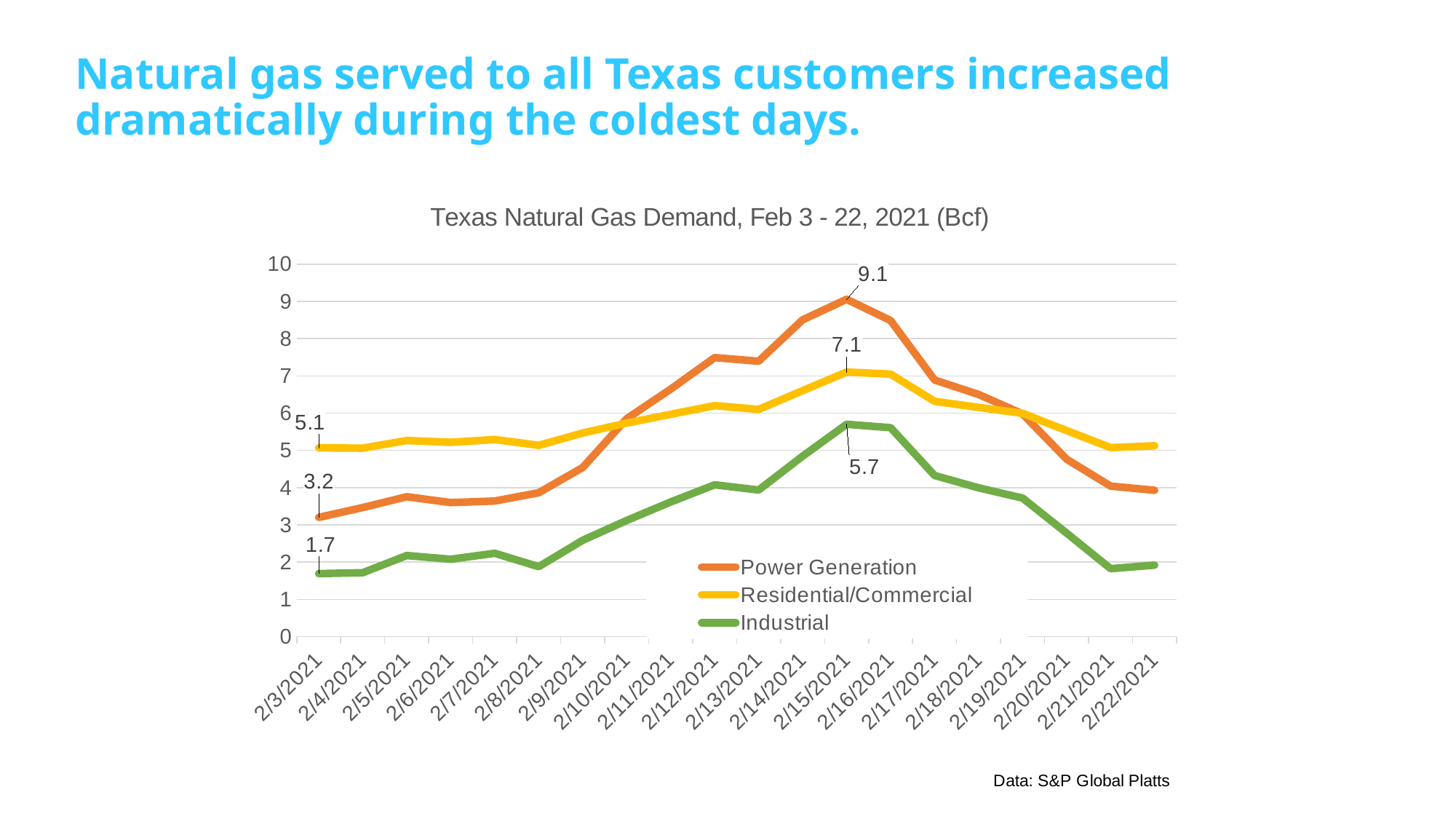
What is the Industrial value on 2/15/2021? 5.7 By how much did Power Generation demand increase from 2/3/2021 to 2/15/2021? 5.9 How many series does the legend list? 3 Does the Power Generation line rise or fall from 2/15/2021 to 2/22/2021? fall What is the Industrial value on 2/3/2021? 1.7 How many dates are plotted along the x axis? 20 Which series has the highest value on 2/15/2021? Power Generation What kind of chart is shown on the slide? line chart Is the Power Generation value on 2/12/2021 greater or less than 7? greater What is the Power Generation value on 2/15/2021? 9.1 What is the Residential/Commercial value on 2/3/2021? 5.1 By how much did Residential/Commercial demand increase from 2/3/2021 to 2/15/2021? 2.0